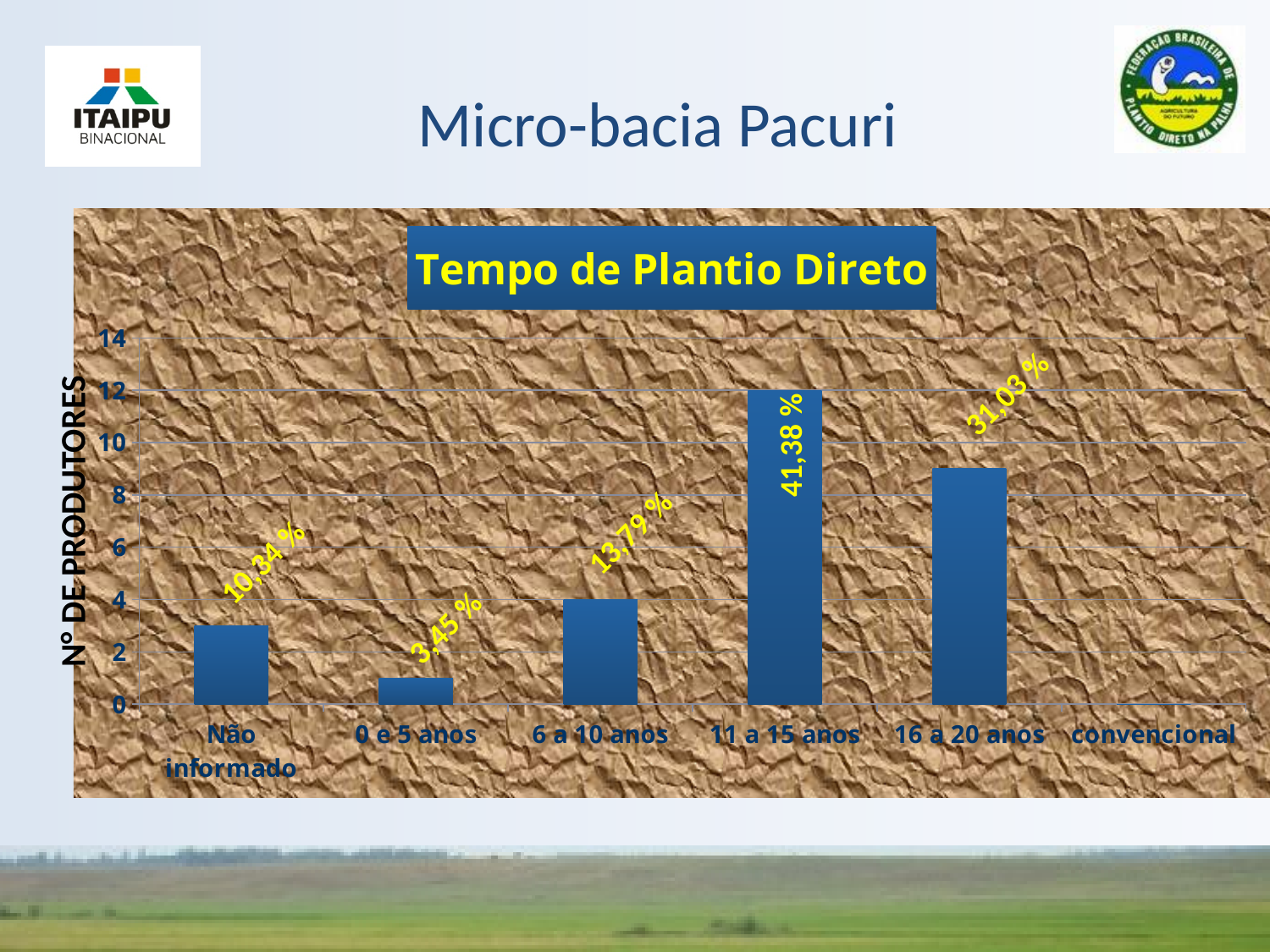
Which has more producers, '16 a 20 anos' or '6 a 10 anos'? 16 a 20 anos What percentage is shown for the category '11 a 15 anos'? 41,38 % What is the title of the chart? Tempo de Plantio Direto How many producers are in the category '11 a 15 anos'? 12 Which category has the highest number of producers? 11 a 15 anos What percentage is shown for the category '0 e 5 anos'? 3,45 % Is the number of producers for 'Não informado' greater or less than 4? less What percentage is shown for the category 'Não informado'? 10,34 % What is the label of the vertical axis? Nº DE PRODUTORES What percentage is shown for the category '16 a 20 anos'? 31,03 % What is the difference between the percentages for '11 a 15 anos' and '16 a 20 anos'? 10,35 % What kind of chart is shown on the slide? bar chart